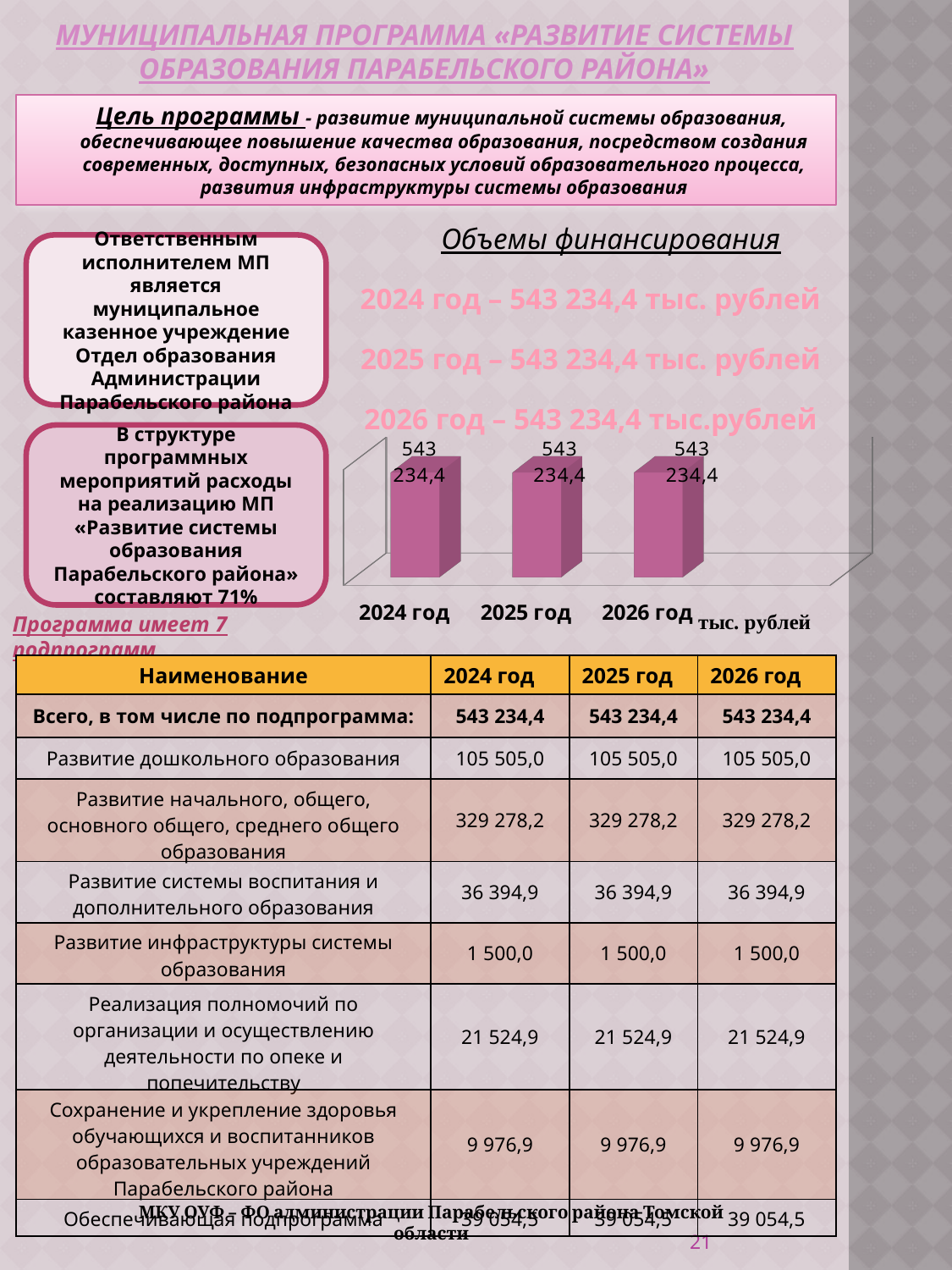
What kind of chart is shown on the slide? Bar chart What is the heading above the bar chart? Объемы финансирования What unit is indicated next to the chart's x axis? тыс. рублей What is the value shown for 2024 год in the bar chart? 543 234,4 What is the value shown for 2026 год in the bar chart? 543 234,4 Do the values in the chart rise, fall, or stay the same from 2024 год to 2026 год? Stay the same What is the difference between the values for 2024 год and 2026 год in the chart? 0 Is the value for 2025 год in the chart the same as the value for 2024 год? Yes How many bars (categories) are plotted in the chart? 3 What is the value shown for 2025 год in the bar chart? 543 234,4